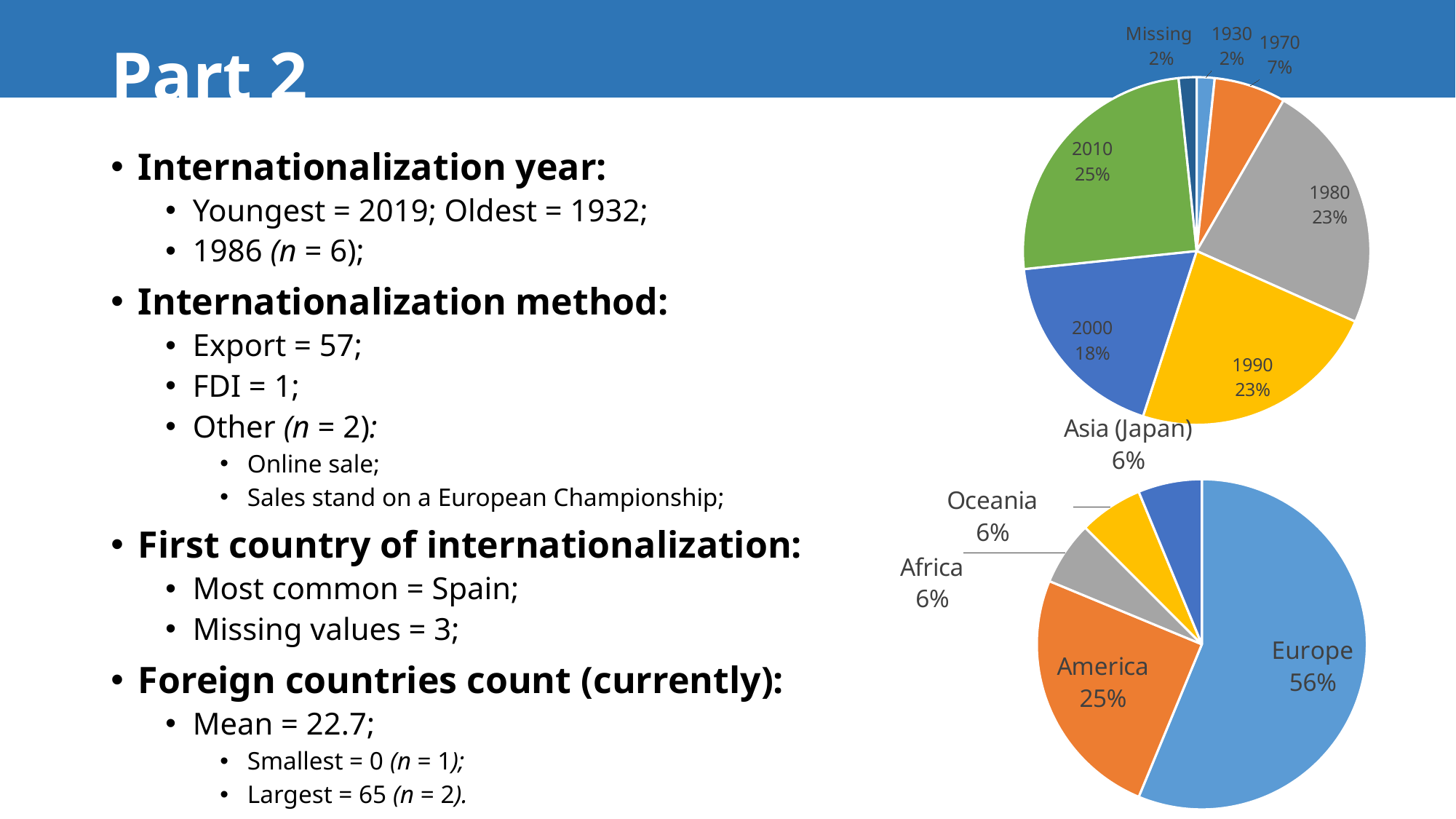
In the bottom pie chart, which category has the largest share? Europe In the bottom pie chart, what share does Europe have? 56% What kind of chart is the top chart on the slide? Pie chart In the top pie chart, which category has the largest share? 2010 How many slices does the bottom pie chart have? 5 In the bottom pie chart, what share does America have? 25% In the top pie chart, what share does the 2010 slice have? 25% In the top pie chart, what share does the 2000 slice have? 18% In the top pie chart, which is larger, the 2000 slice or the 1980 slice? 1980 How many slices does the top pie chart have? 7 In the bottom pie chart, what is the difference in percentage points between Europe and America? 31 In the top pie chart, what is the difference in percentage points between the 2010 slice and the 1970 slice? 18